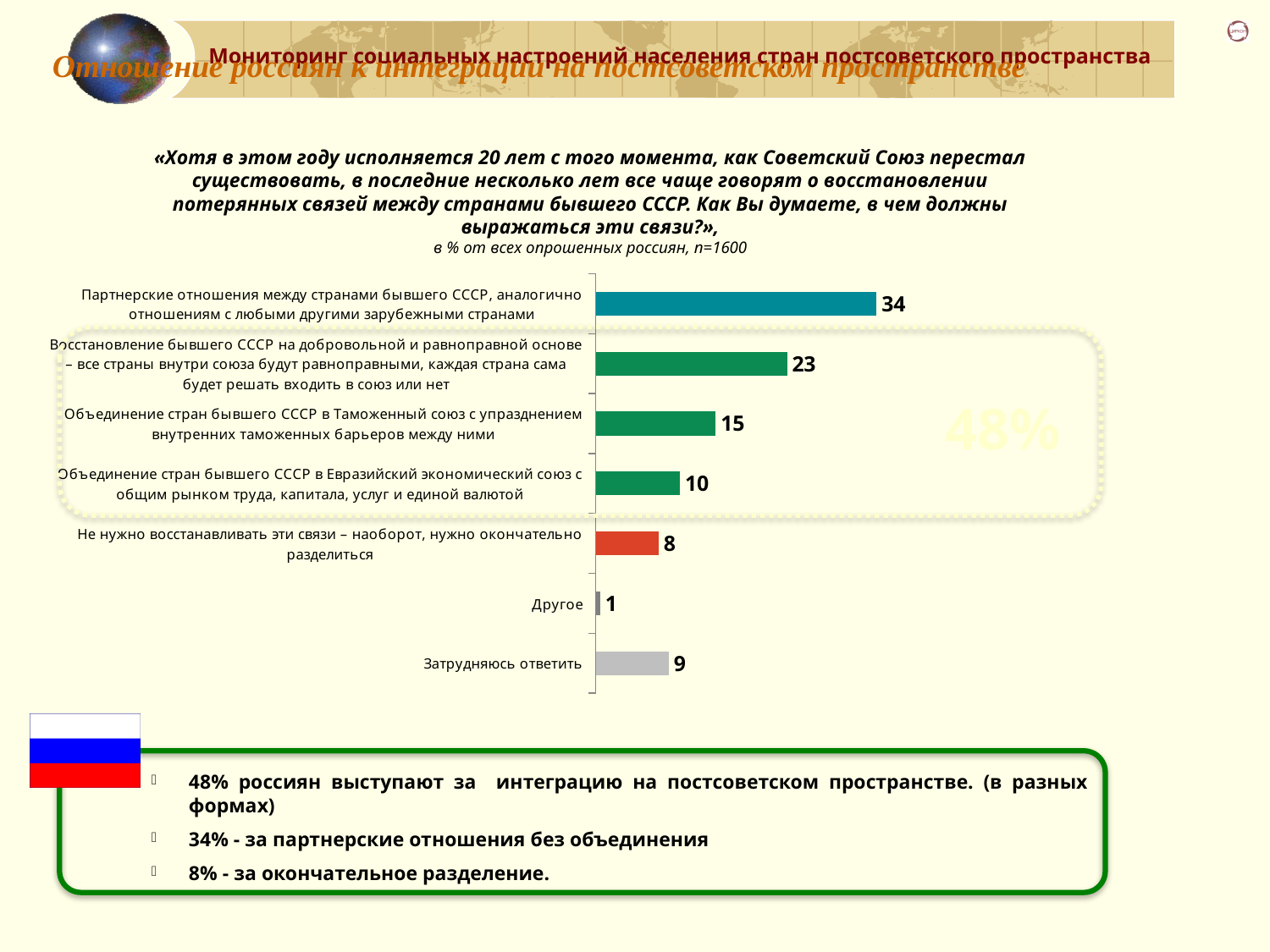
Which category has the lowest value in the chart? Другое How many categories are shown in the chart? 7 Which category has the highest value in the chart? Партнерские отношения между странами бывшего СССР, аналогично отношениям с любыми другими зарубежными странами What value is shown for "Затрудняюсь ответить"? 9 What value is shown for "Не нужно восстанавливать эти связи – наоборот, нужно окончательно разделиться"? 8 What colour is the bar for "Не нужно восстанавливать эти связи – наоборот, нужно окончательно разделиться"? Red What type of chart is shown on the slide? Bar chart What value is shown for "Партнерские отношения между странами бывшего СССР, аналогично отношениям с любыми другими зарубежными странами"? 34 What value is shown for "Объединение стран бывшего СССР в Таможенный союз с упразднением внутренних таможенных барьеров между ними"? 15 What is the difference between the value for "Восстановление бывшего СССР на добровольной и равноправной основе..." and the value for "Объединение стран бывшего СССР в Евразийский экономический союз..."? 13 What is the sample size (n) stated in the chart subtitle? n=1600 Which is larger: the value for "Затрудняюсь ответить" or the value for "Не нужно восстанавливать эти связи – наоборот, нужно окончательно разделиться"? Затрудняюсь ответить